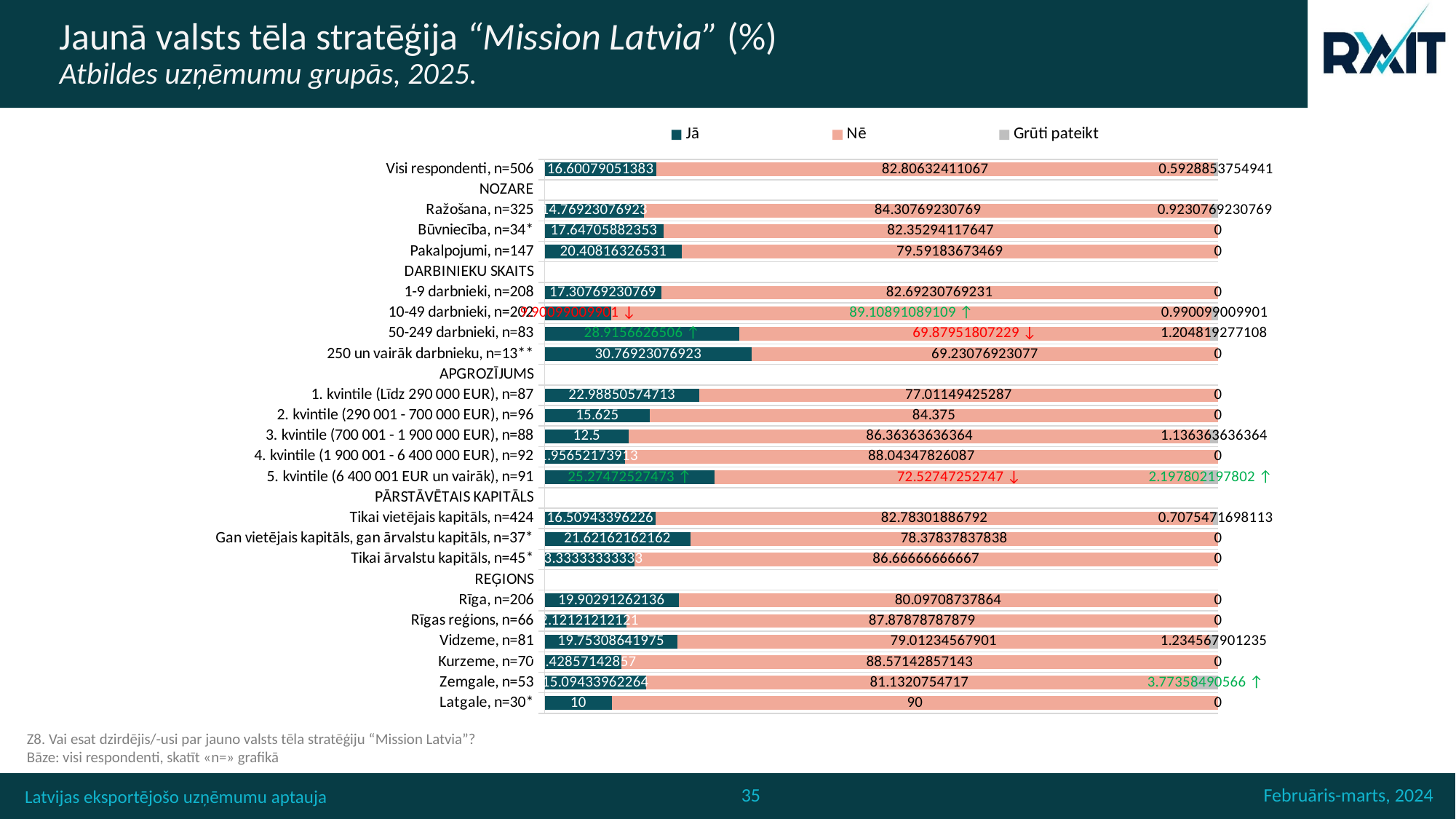
What kind of chart is shown on the slide? bar chart What is the "Nē" value for "Latgale, n=30*"? 90 What is the total of the stacked bar for "Latgale, n=30*"? 100 Which has the larger "Jā" value: "Pakalpojumi, n=147" or "Ražošana, n=325"? Pakalpojumi, n=147 What is the "Jā" value for "Visi respondenti, n=506"? 16.60079051383 Which group has the highest "Jā" value? 250 un vairāk darbinieku, n=13** What is the difference between the "Nē" and "Jā" values for "2. kvintile (290 001 - 700 000 EUR), n=96"? 68.75 What is the "Jā" value for "2. kvintile (290 001 - 700 000 EUR), n=96"? 15.625 What is the "Grūti pateikt" value for "Zemgale, n=53"? 3.77358490566 How many series does the legend list? 3 What are the three legend entries of the chart? Jā, Nē, Grūti pateikt Which group has the lowest "Jā" value? 10-49 darbnieki, n=202